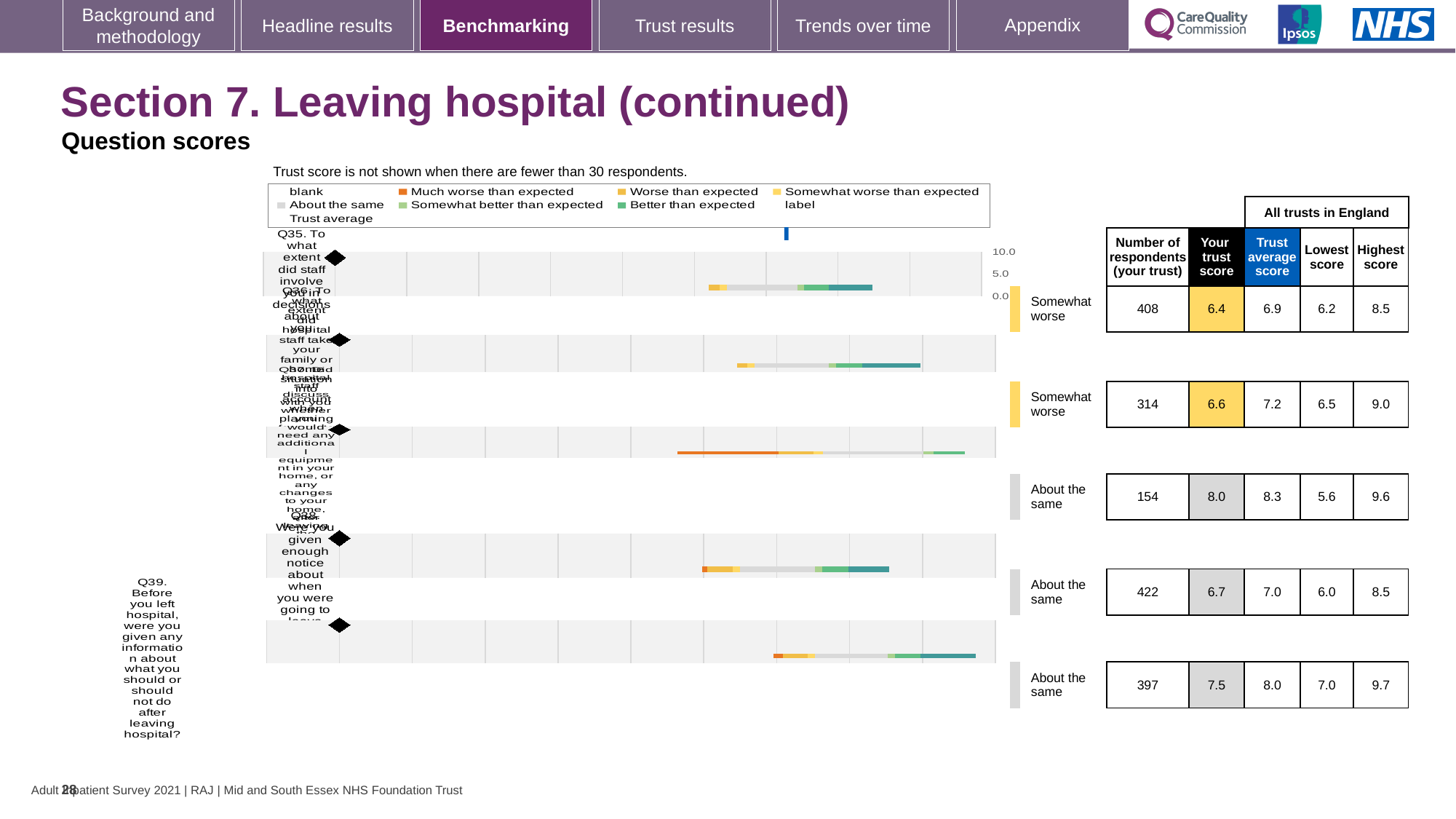
What is the highest 'Your trust score' shown in the table? 8.0 How many respondents answered Q39 (information about what you should or should not do after leaving hospital)? 397 How many of the question rows are rated 'About the same'? 3 For Q35, which is larger: your trust score or the trust average score? Trust average score What benchmark category is shown for Q35, the first row? Somewhat worse What is the lowest 'Your trust score' shown in the table? 6.4 What is the 'Your trust score' for Q35 (to what extent did staff involve you in decisions about leaving hospital)? 6.4 For Q39, what is the difference between the trust average score (8.0) and your trust score (7.5)? 0.5 How many question rows are shown in the benchmarking table? 5 What kind of chart is used to show the question scores? Bar chart What is the highest score among all trusts in England for Q39, the last row of the table? 9.7 What is the trust average score for all trusts in England for Q35, the first row of the table? 6.9